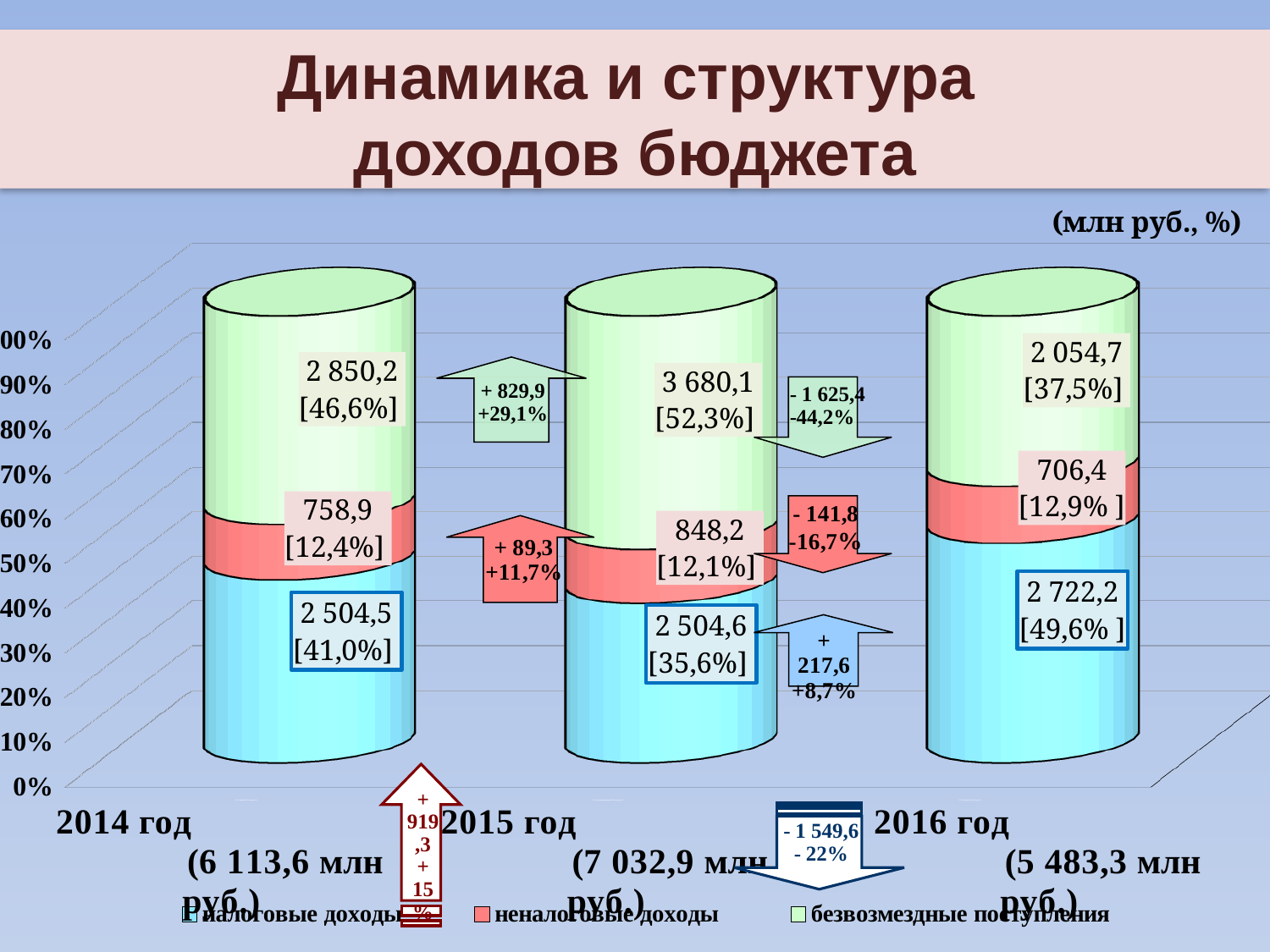
By how much did налоговые доходы change from 2015 год to 2016 год? + 217,6 Which is larger: безвозмездные поступления in 2014 год or in 2016 год? 2014 год How many series does the legend list? 3 Which series is shown in red on the chart? неналоговые доходы In which year is the value of безвозмездные поступления highest? 2015 год What share of the 2015 год budget revenue is безвозмездные поступления? 52,3% What is the total budget revenue for 2015 год? 7 032,9 млн руб. What is the value of неналоговые доходы for 2016 год? 706,4 What kind of chart is shown on the slide? Stacked bar chart In which year is the value of неналоговые доходы lowest? 2016 год How many years are shown on the chart? 3 What is the value of налоговые доходы for 2014 год? 2 504,5